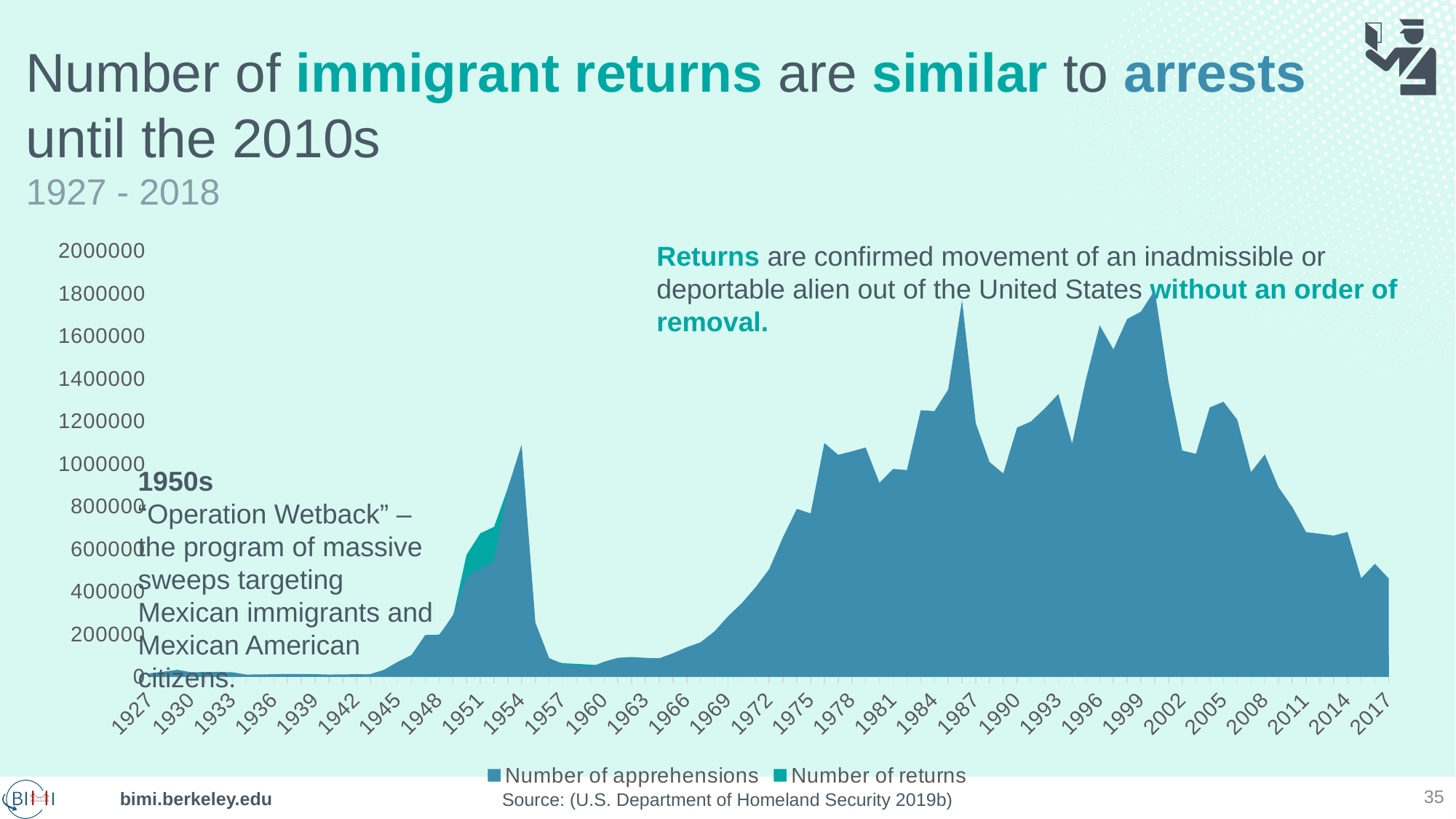
Do the values generally rise or fall along the x axis from 2005 to 2017? fall Is the number of apprehensions in 2000 greater or less than 1400000? greater Is the number of apprehensions in 1936 greater or less than 200000? less What is the highest value shown on the chart's vertical axis? 2000000 Is the number of apprehensions in 1960 greater or less than 200000? less What are the two series named in the chart legend? Number of apprehensions; Number of returns How many series does the chart legend list? 2 Do the values generally rise or fall along the x axis from 1963 to 1986? rise What kind of chart is shown on the slide? Area chart